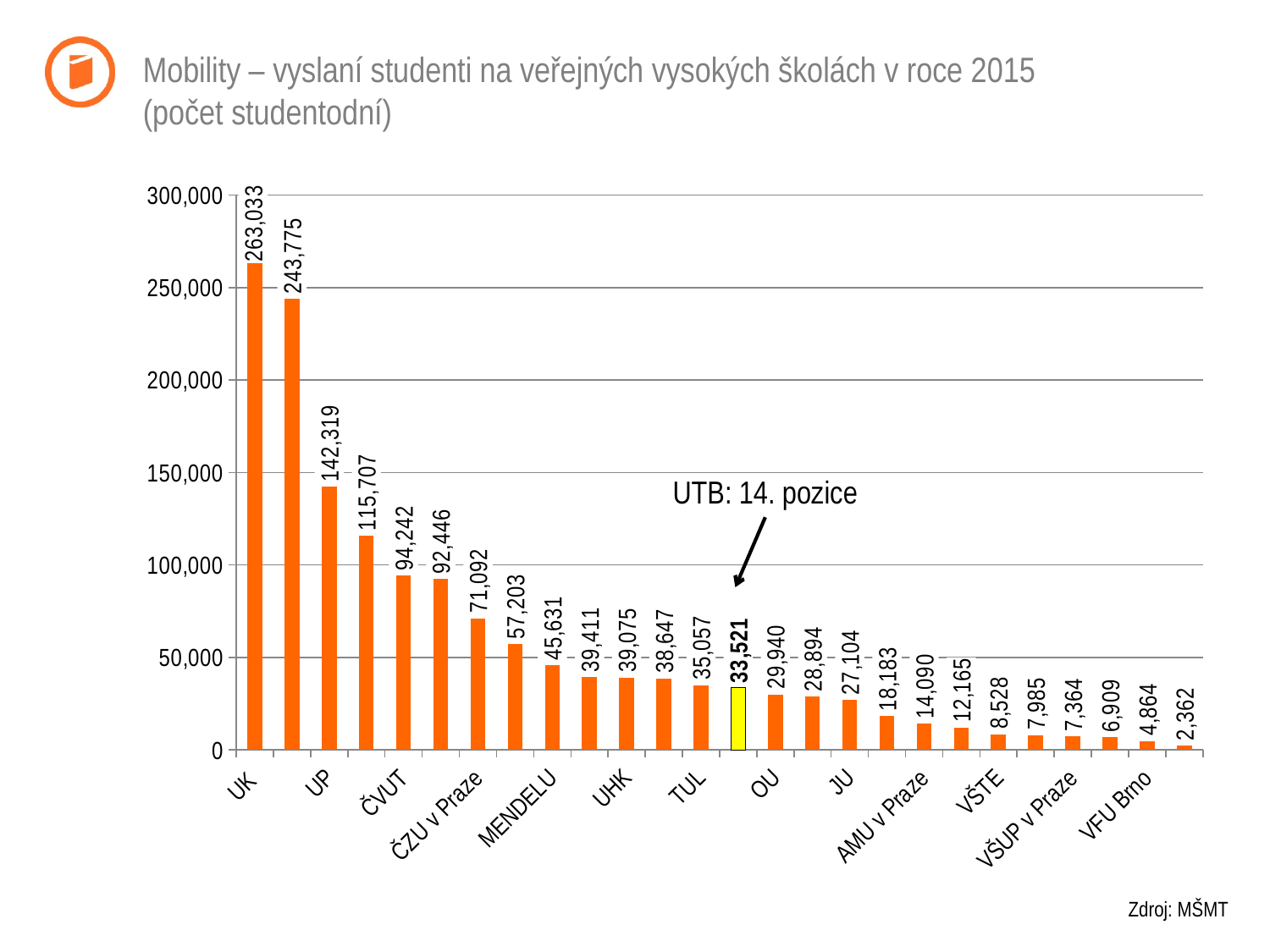
What is the value for UK? 263,033 What is the value for VFU Brno? 4,864 What is the difference between the values for TUL and UTB? 1,536 What kind of chart is shown on the slide? bar chart Which university has the highest value? UK What is the value for UTB (the highlighted bar)? 33,521 How many bars are plotted in the chart? 26 According to the annotation, what position does UTB hold? 14. pozice Which is larger, the value for ČVUT or the value for ČZU v Praze? ČVUT Do the values rise or fall from left to right along the x axis? fall What is the difference between the values for UK and UP? 120,714 Is the value for MENDELU greater or less than 50,000? less